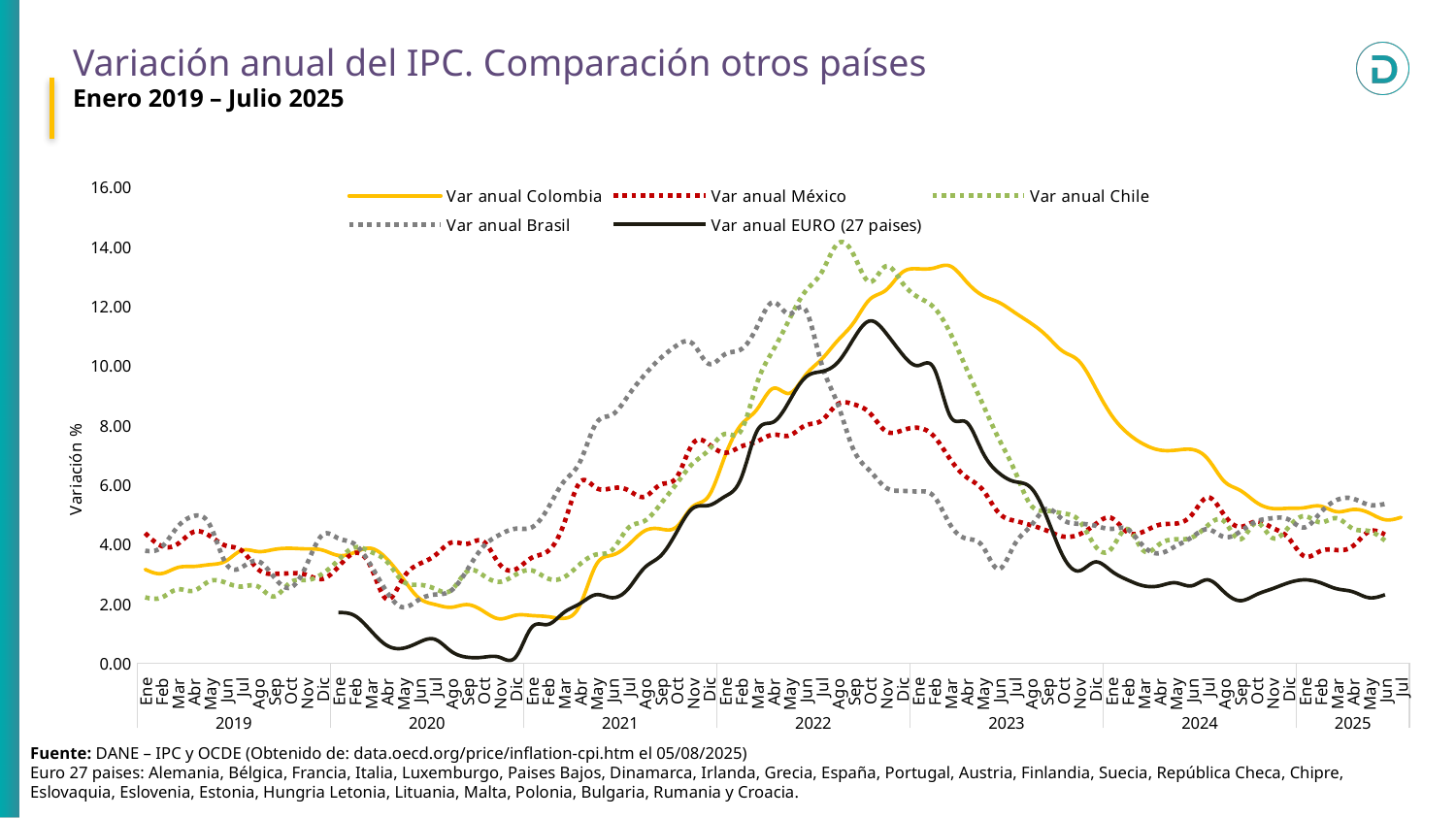
What kind of chart is shown on the slide? Line chart Does the Var anual Colombia line rise or fall between Mar 2023 and Dic 2024? Falls Which series are listed in the chart legend? Var anual Colombia, Var anual México, Var anual Chile, Var anual Brasil, Var anual EURO (27 paises) Is the value for Var anual Colombia in Mar 2023 greater or less than 12.00? greater How many series does the legend list? 5 What is the label on the vertical axis of the chart? Variación % Is the value for Var anual Colombia in Ene 2019 greater or less than 4.00? less Is the value for Var anual Brasil in Oct 2021 greater or less than 8.00? greater Does the Var anual EURO (27 paises) line rise or fall between Ene 2021 and Oct 2022? Rises